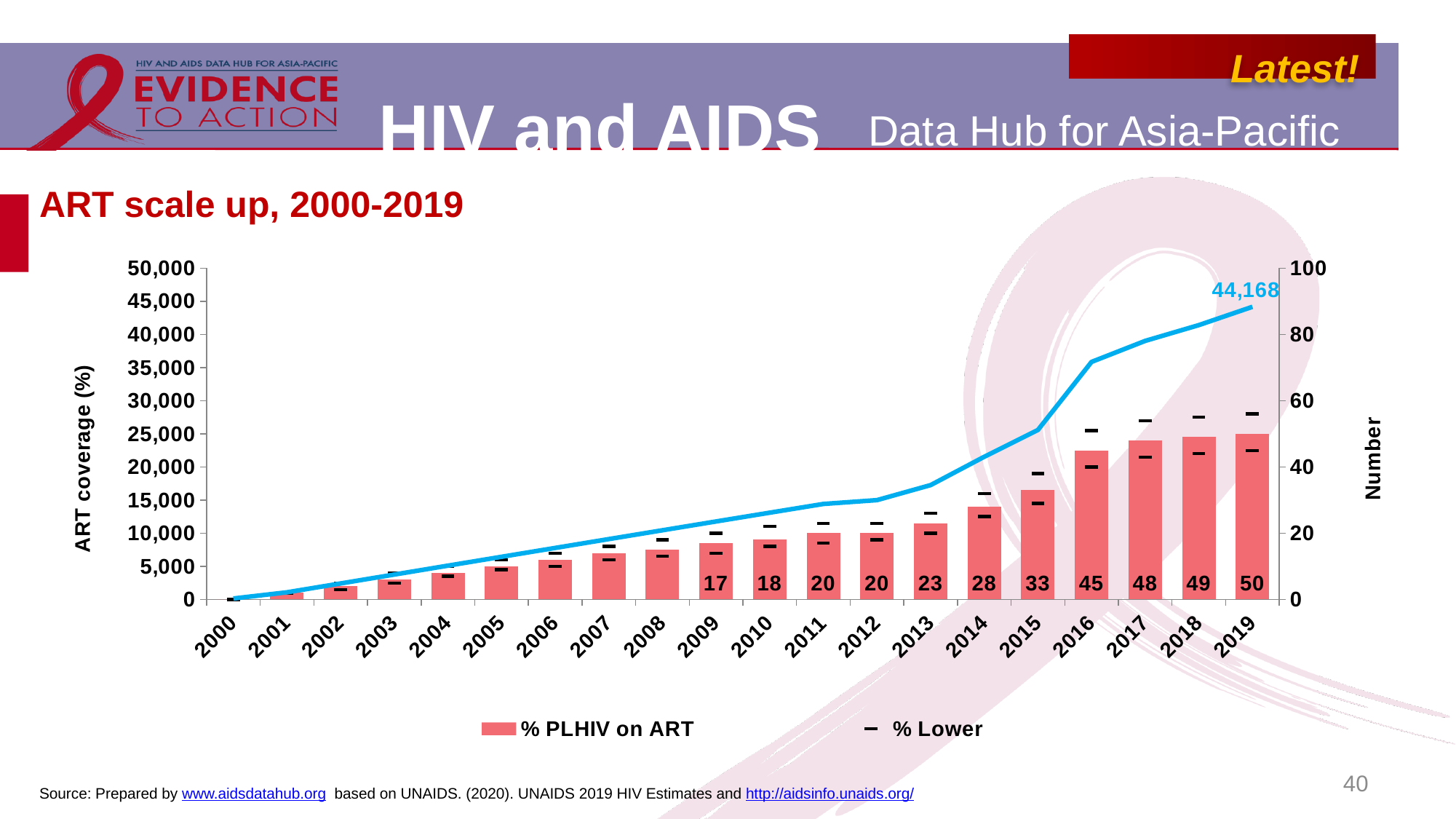
What is the % PLHIV on ART value shown for 2009? 17 What is the difference between the % PLHIV on ART values for 2019 and 2009? 33 Which year has the highest % PLHIV on ART bar? 2019 Is the % PLHIV on ART bar for 2005 greater or less than 20 on the right-hand axis? less Do the % PLHIV on ART bars rise or fall from 2000 to 2019? Rise How many years are shown on the x axis? 20 Which year has a larger % PLHIV on ART value, 2014 or 2015? 2015 What kind of chart is shown on the slide? Combined bar and line chart How many entries does the legend list? 2 What value is labelled on the blue line at 2019? 44,168 What is the % PLHIV on ART value shown for 2016? 45 What is the % PLHIV on ART value shown for 2019? 50